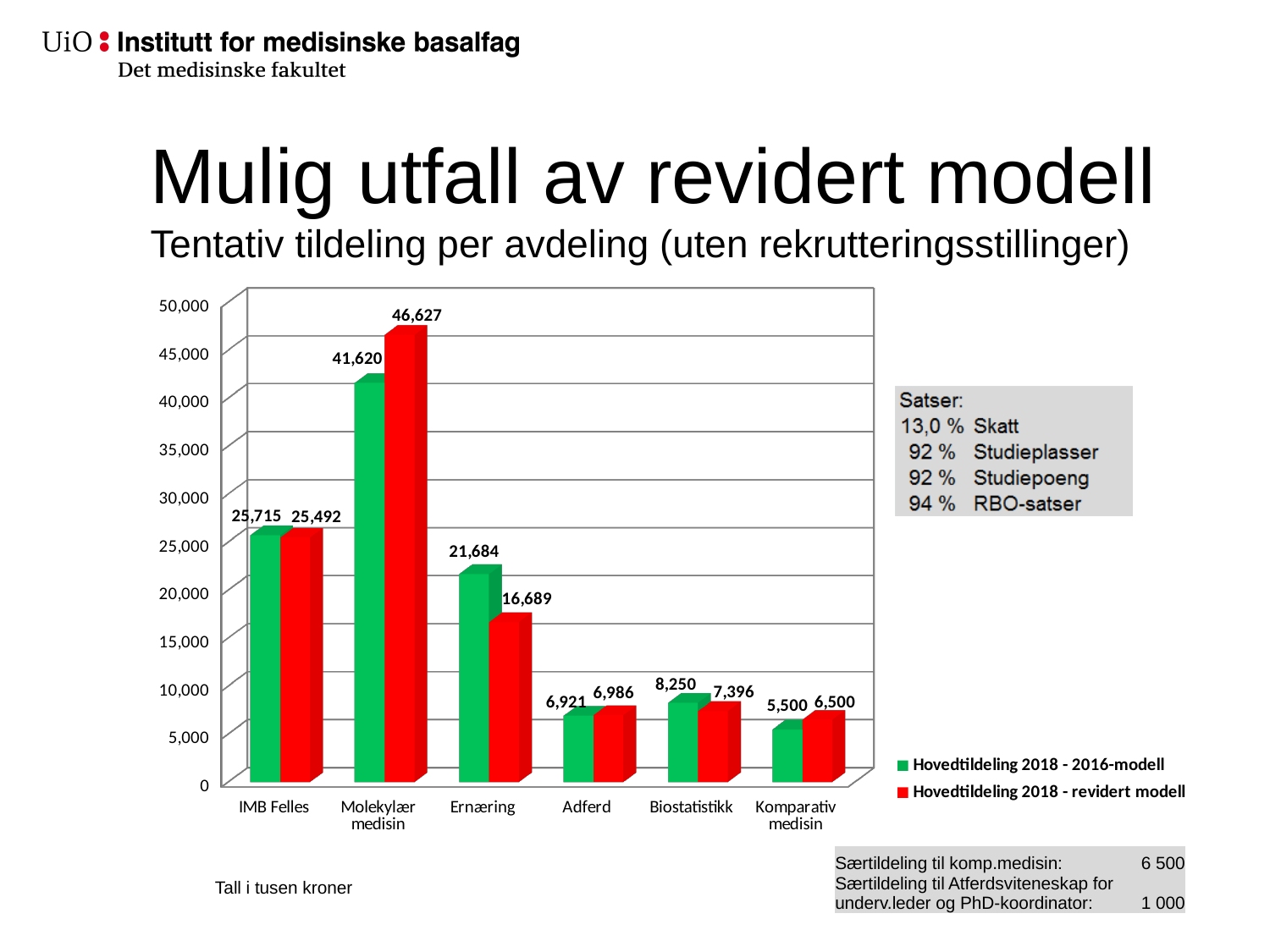
What is the difference between the 2016-modell and revidert modell values for Ernæring? 4,995 How many series does the legend list? 2 What kind of chart is shown on the slide? Bar chart How many categories are shown on the x axis? 6 What is the value for Molekylær medisin in the 'Hovedtildeling 2018 - revidert modell' series? 46,627 For Biostatistikk, which series has the larger value: 2016-modell or revidert modell? 2016-modell What is the value for Komparativ medisin in the 'Hovedtildeling 2018 - revidert modell' series? 6,500 What is the difference between the revidert modell and 2016-modell values for Molekylær medisin? 5,007 What is the value for Ernæring in the 'Hovedtildeling 2018 - 2016-modell' series? 21,684 What colour represents the 'Hovedtildeling 2018 - revidert modell' series? Red Which category has the highest value in the 'Hovedtildeling 2018 - 2016-modell' series? Molekylær medisin Which category has the lowest value in the 'Hovedtildeling 2018 - revidert modell' series? Komparativ medisin